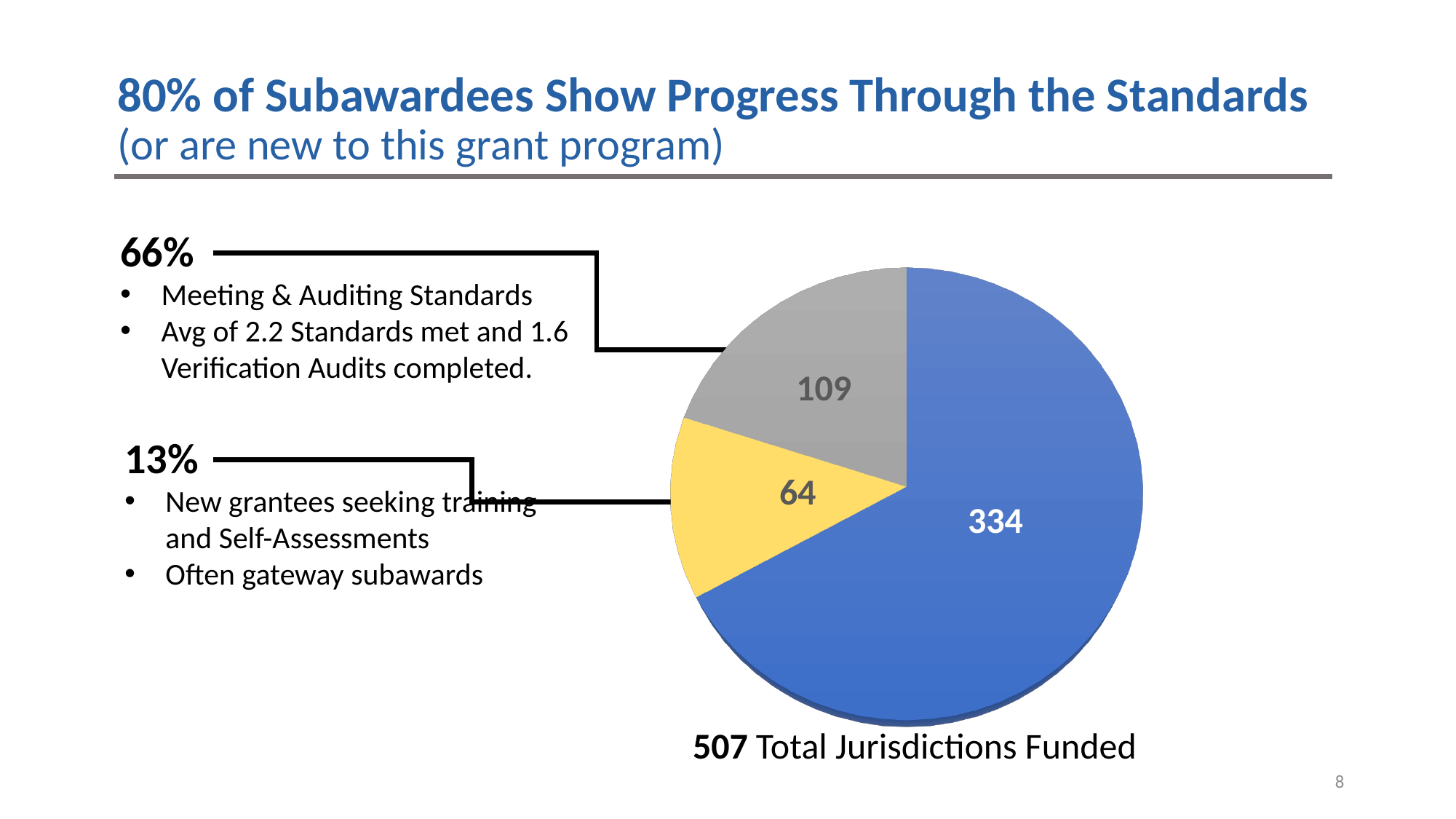
What value is shown on the yellow slice of the pie chart? 64 What is the total number of jurisdictions funded according to the caption under the pie chart? 507 Which slice of the pie chart has the smallest value? the yellow slice (64) Which slice of the pie chart has the largest value? the blue slice (334) What kind of chart is shown on the slide? pie chart What is the difference between the blue slice value and the gray slice value? 225 What value is shown on the blue slice of the pie chart? 334 Which is larger, the gray slice value or the yellow slice value? the gray slice (109) What value is shown on the gray slice of the pie chart? 109 What is the difference between the gray slice value and the yellow slice value? 45 How many slices does the pie chart have? 3 According to the slide, what percentage of subawardees are new grantees seeking training and Self-Assessments? 13%